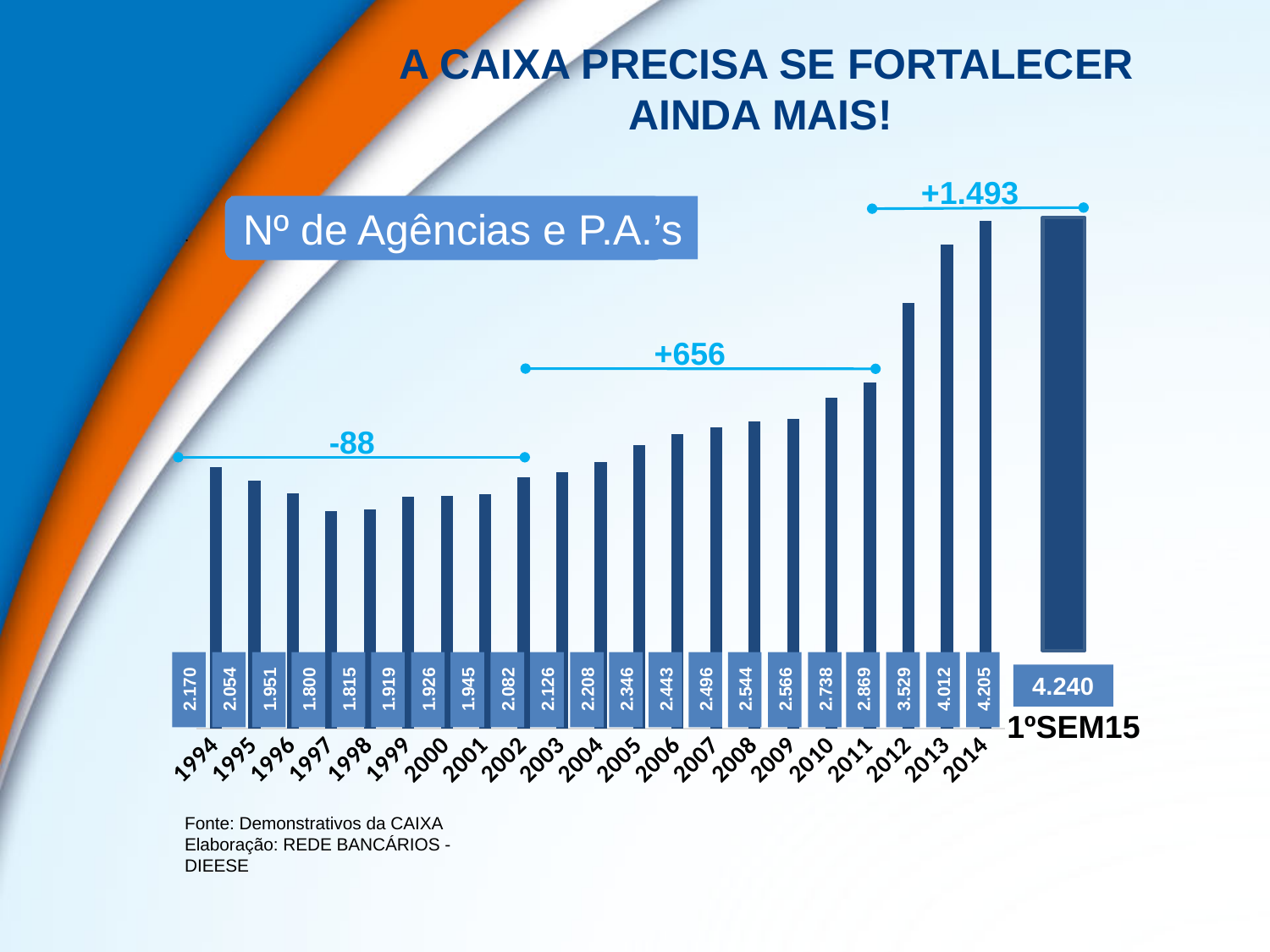
What is the difference between the values for 2014 and 2013? 193 Which bar has the highest value in the chart? 1ºSEM15 Do the values rise or fall from 2002 to 2014? Rise Which is larger, the value for 1994 or the value for 2002? 1994 What is the difference between the values for 2012 and 2011? 660 What is the value for 1997 in the chart? 1.800 What is the value for 2012 in the chart? 3.529 Which year has the lowest value in the chart? 1997 What is the value shown for 1ºSEM15? 4.240 What kind of chart is shown on the slide? Bar chart What is the title of the chart? Nº de Agências e P.A.'s How many bars are plotted in the chart? 22